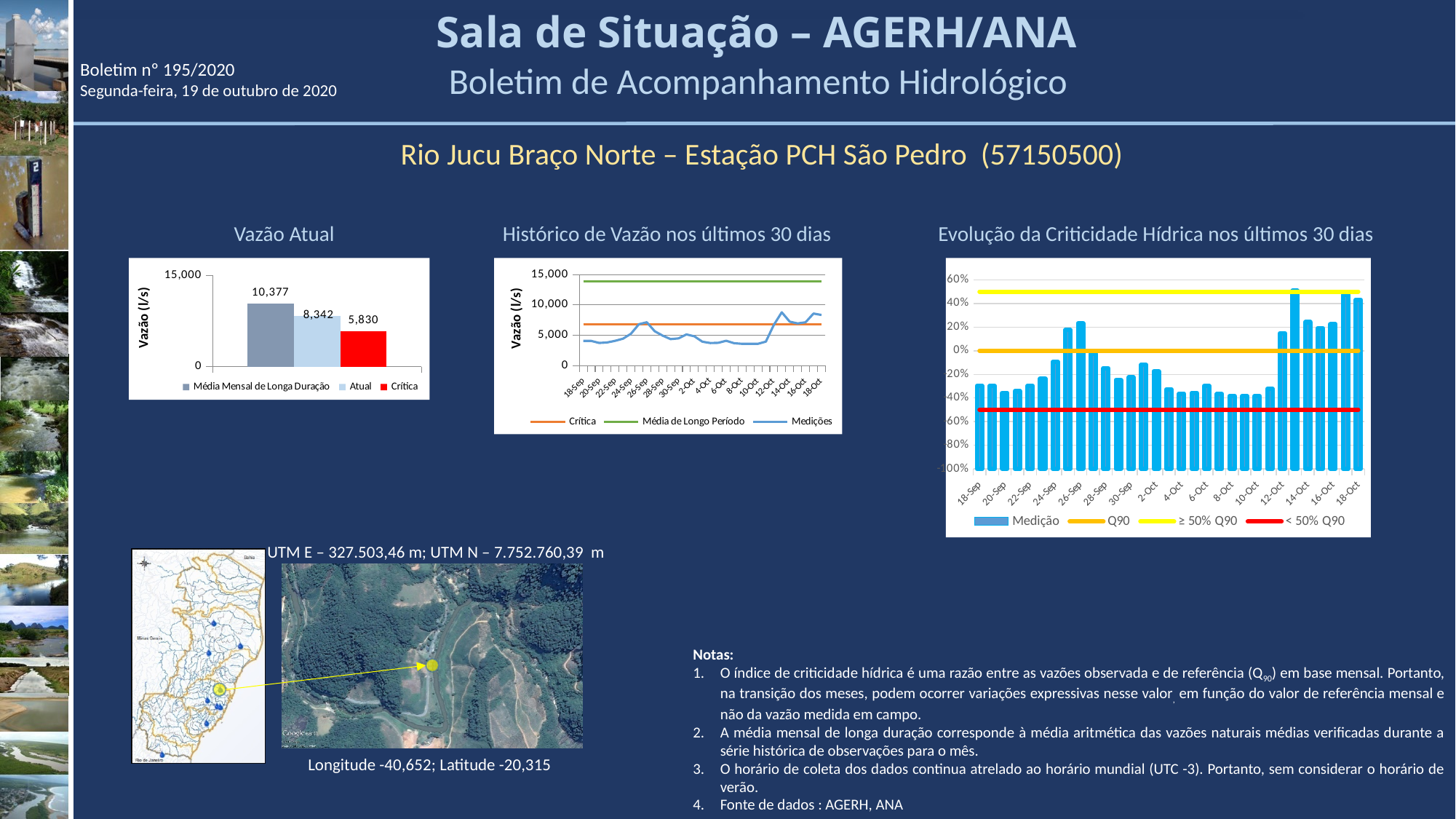
What kind of chart is 'Histórico de Vazão nos últimos 30 dias'? line chart In the 'Vazão Atual' chart, what is the value for Crítica? 5,830 In the 'Vazão Atual' chart, which series has the highest value? Média Mensal de Longa Duração In the 'Vazão Atual' chart, what is the difference between Média Mensal de Longa Duração and Atual? 2,035 In the 'Vazão Atual' chart, what is the value for Média Mensal de Longa Duração? 10,377 In the 'Vazão Atual' chart, which is larger, Atual or Crítica? Atual In the 'Vazão Atual' chart, what is the difference between Atual and Crítica? 2,512 In the 'Histórico de Vazão nos últimos 30 dias' chart, is the Média de Longo Período line greater or less than 10,000? greater How many series does the legend of 'Histórico de Vazão nos últimos 30 dias' list? 3 In the 'Vazão Atual' chart, what is the value for Atual? 8,342 In the 'Evolução da Criticidade Hídrica nos últimos 30 dias' chart, is the Medição value for 18-Oct greater or less than 20%? greater In the 'Vazão Atual' chart, how many bars are plotted? 3